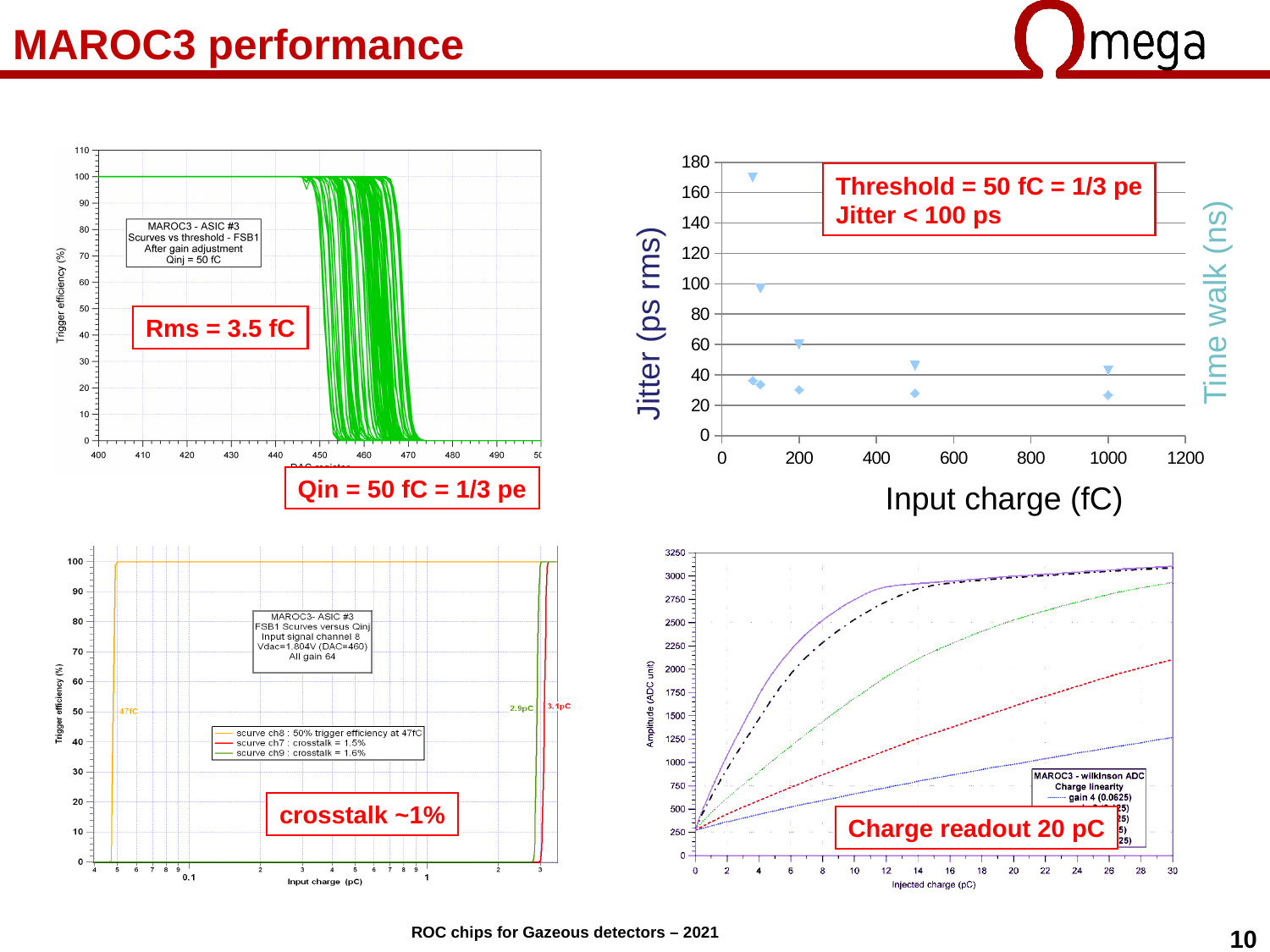
In the top-right chart, what is the label of the x axis? Input charge (fC) In the top-right chart, does the jitter of the triangle series rise or fall as input charge increases? fall In the top-right chart, what is the largest value shown on the x axis? 1200 In the bottom-left chart, what crosstalk value is given for scurve ch9? 1.6% In the top-right chart, is the highest triangle point (near 100 fC) greater or less than 140 ps rms? greater In the top-right chart, is the diamond point at 1000 fC greater or less than 40 ps rms? less In the bottom-left chart, how many series does the legend list? 3 In the bottom-left chart, what crosstalk value is given for scurve ch7? 1.5% In the bottom-right chart, does the amplitude rise or fall as injected charge increases? rise In the bottom-left chart, at what input charge does scurve ch8 reach 50% trigger efficiency? 47fC What kind of chart is the top-right chart of jitter versus input charge? scatter chart In the bottom-left chart, which channel has the larger crosstalk, ch7 or ch9? ch9